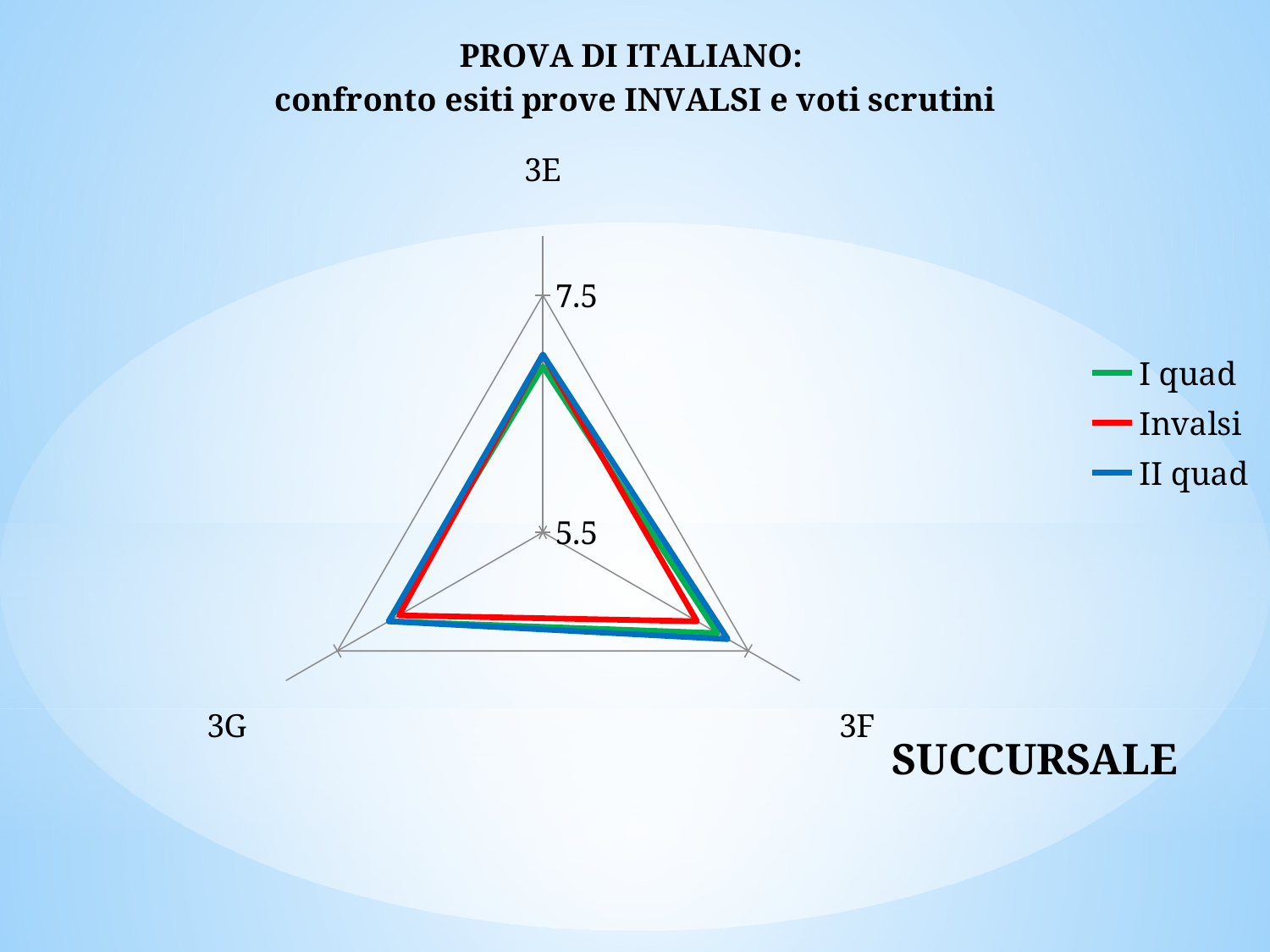
Which colour represents the Invalsi series in the legend? red How many classes (categories) are plotted on the chart? 3 Is the II quad value for 3E greater or less than 7.5? less Is the Invalsi value for 3G greater or less than 5.5? greater How many series does the legend list? 3 Is the I quad value for 3E greater or less than 7.5? less What kind of chart is shown on the slide? radar chart For the II quad series, which class has the lowest value? 3E and 3G (tied) For class 3F, which is larger: the Invalsi value or the II quad value? II quad For class 3G, which is larger: the Invalsi value or the II quad value? II quad For the Invalsi series, which class has the lowest value? 3G What is the title of the chart? PROVA DI ITALIANO: confronto esiti prove INVALSI e voti scrutini